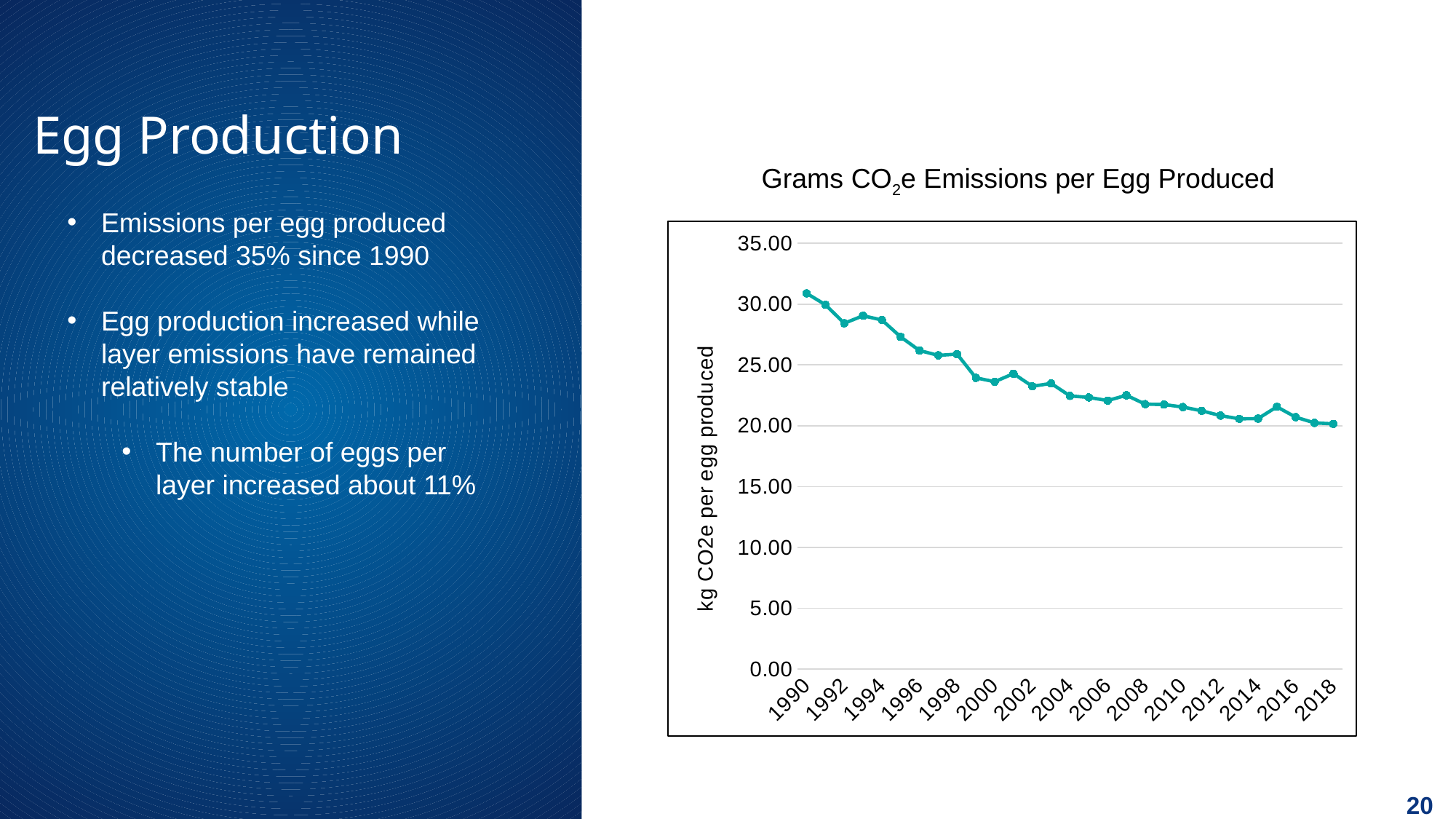
Which is larger, the value for 1994 or the value for 2004? 1994 Is the value for 2000 greater or less than 25.00? less What is the title of the chart? Grams CO2e Emissions per Egg Produced How many year labels are shown on the x axis? 15 What is the label on the vertical axis of the chart? kg CO2e per egg produced What kind of chart is shown on the slide? line chart Which is larger, the value for 1990 or the value for 2018? 1990 Do the values generally rise or fall from 1990 to 2018? fall Is the value for 1996 greater or less than 25.00? greater Is the value for 2010 greater or less than 25.00? less Which year has the highest value in the chart? 1990